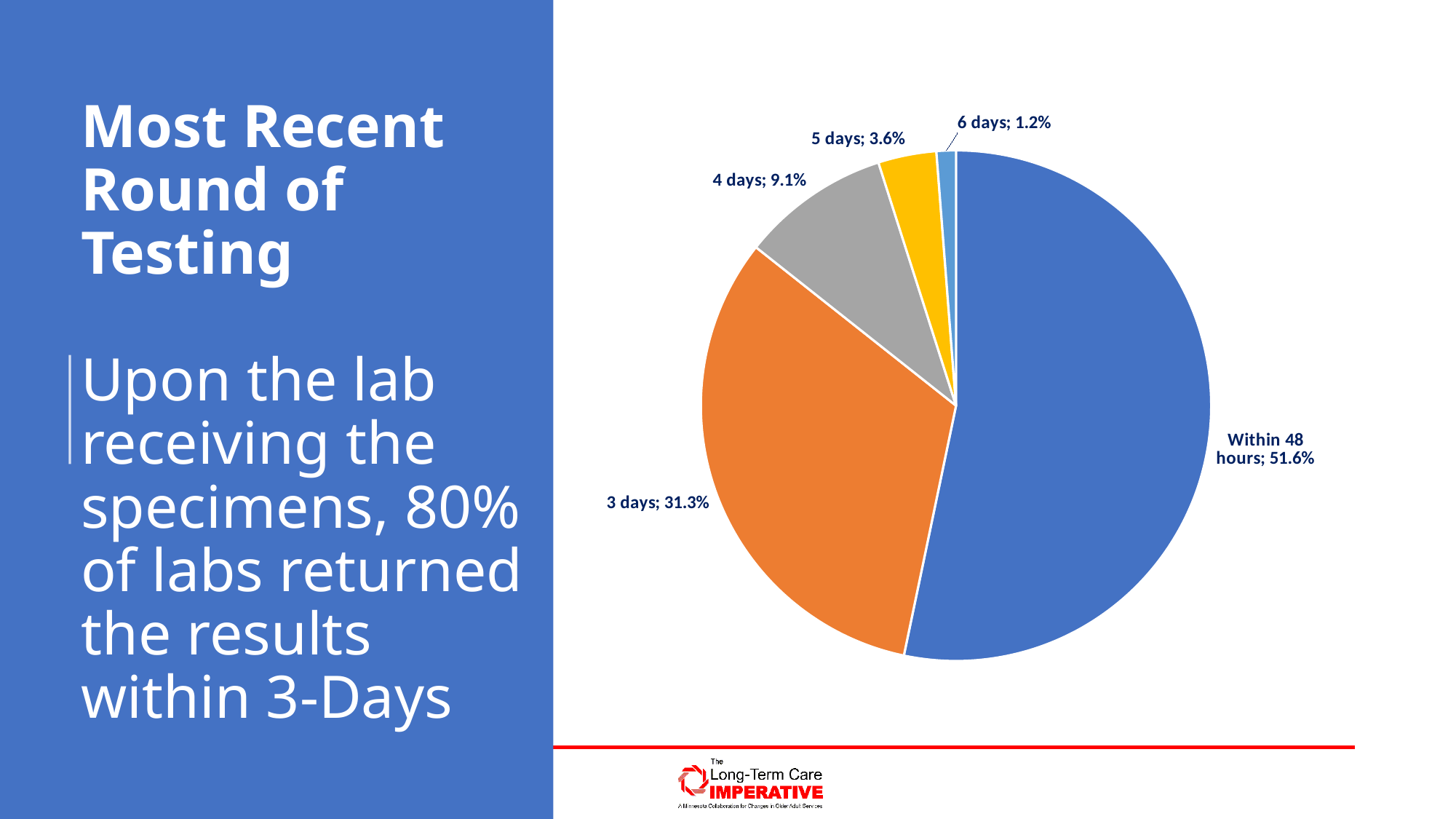
What share of the pie is labelled '5 days'? 3.6% Which slice of the pie is the smallest? 6 days What is the difference in percentage points between the 'Within 48 hours' slice and the '3 days' slice? 20.3 What kind of chart is shown on the slide? Pie chart Which slice is larger, '4 days' or '5 days'? 4 days What share of the pie is labelled '3 days'? 31.3% What share of the pie is labelled 'Within 48 hours'? 51.6% What share of the pie is labelled '6 days'? 1.2% What share of the pie is labelled '4 days'? 9.1% How many slices does the pie chart have? 5 What colour is the '3 days' slice? Orange Which slice of the pie is the largest? Within 48 hours